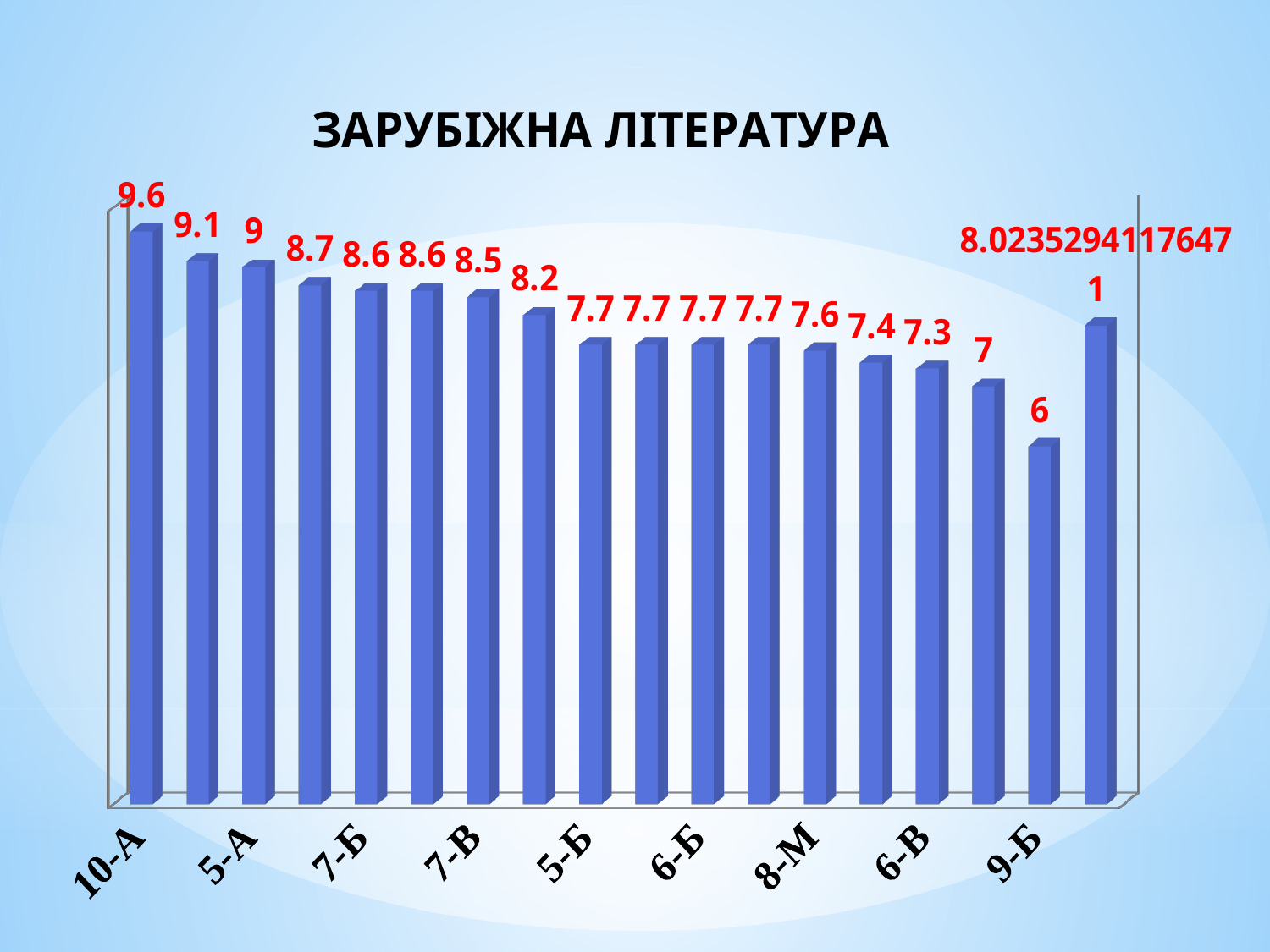
What is the value for 8-М? 7.6 Which labelled class has the highest value? 10-А What is the difference between the values for 10-А and 9-Б? 3.6 What kind of chart is shown on the slide? bar chart Which labelled class has the lowest value? 9-Б What is the value for 5-А? 9 What is the value for 7-В? 8.5 What is the title of the chart? ЗАРУБІЖНА ЛІТЕРАТУРА What is the value for 10-А? 9.6 Which has a larger value, 5-А or 6-В? 5-А What is the value for 9-Б? 6 What is the value for 7-Б? 8.6